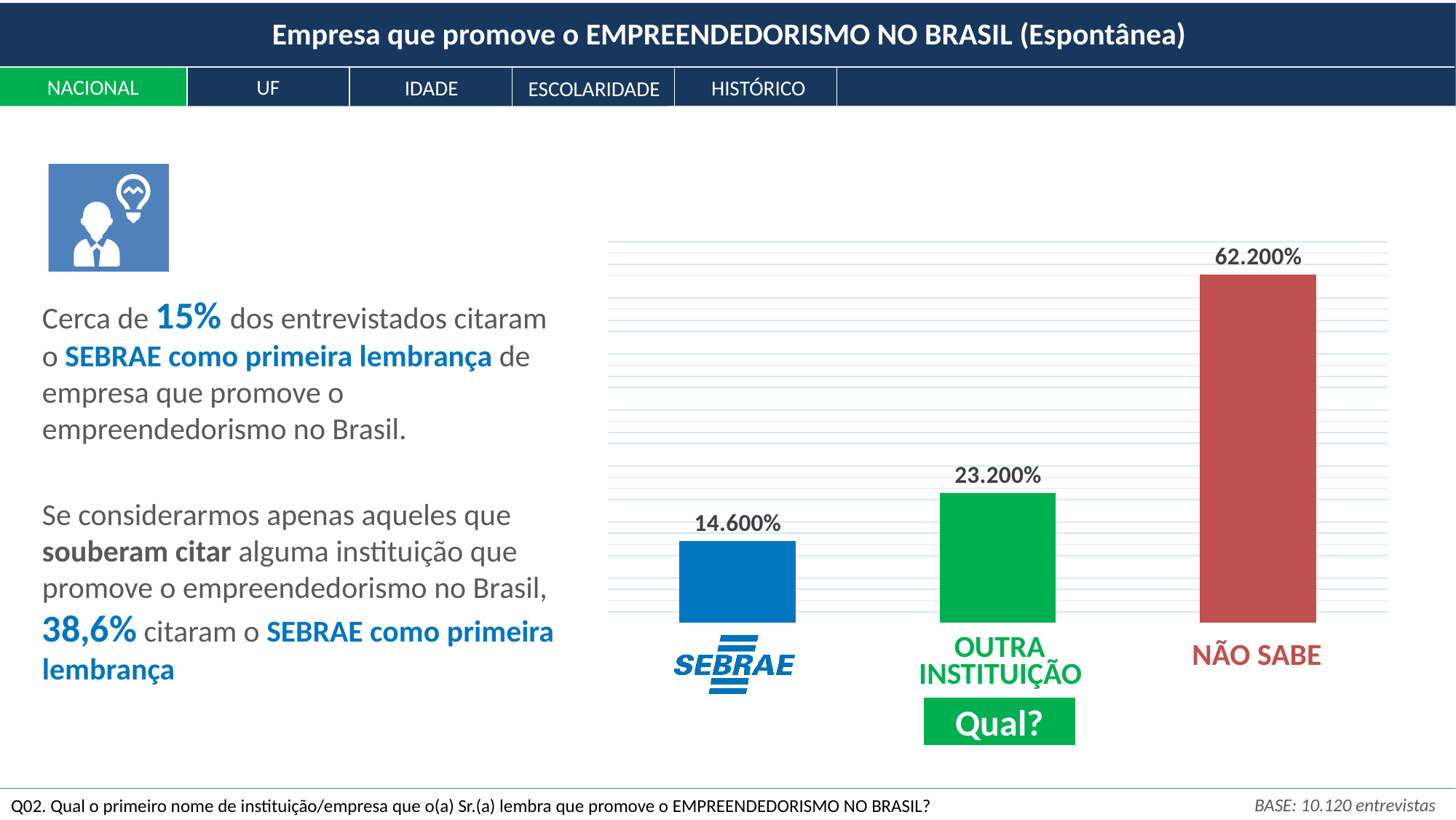
How many categories are shown in the chart? 3 What is the difference between the values for OUTRA INSTITUIÇÃO and SEBRAE? 8.600% What is the value for NÃO SABE? 62.200% What is the difference between the values for NÃO SABE and SEBRAE? 47.600% What colour is the bar for NÃO SABE? red Which category has the highest value? NÃO SABE What is the value for SEBRAE? 14.600% Do the values rise or fall from left to right across the categories? rise What kind of chart is shown on the slide? bar chart Which category has the lowest value? SEBRAE Which is larger, the value for OUTRA INSTITUIÇÃO or the value for SEBRAE? OUTRA INSTITUIÇÃO What is the value for OUTRA INSTITUIÇÃO? 23.200%